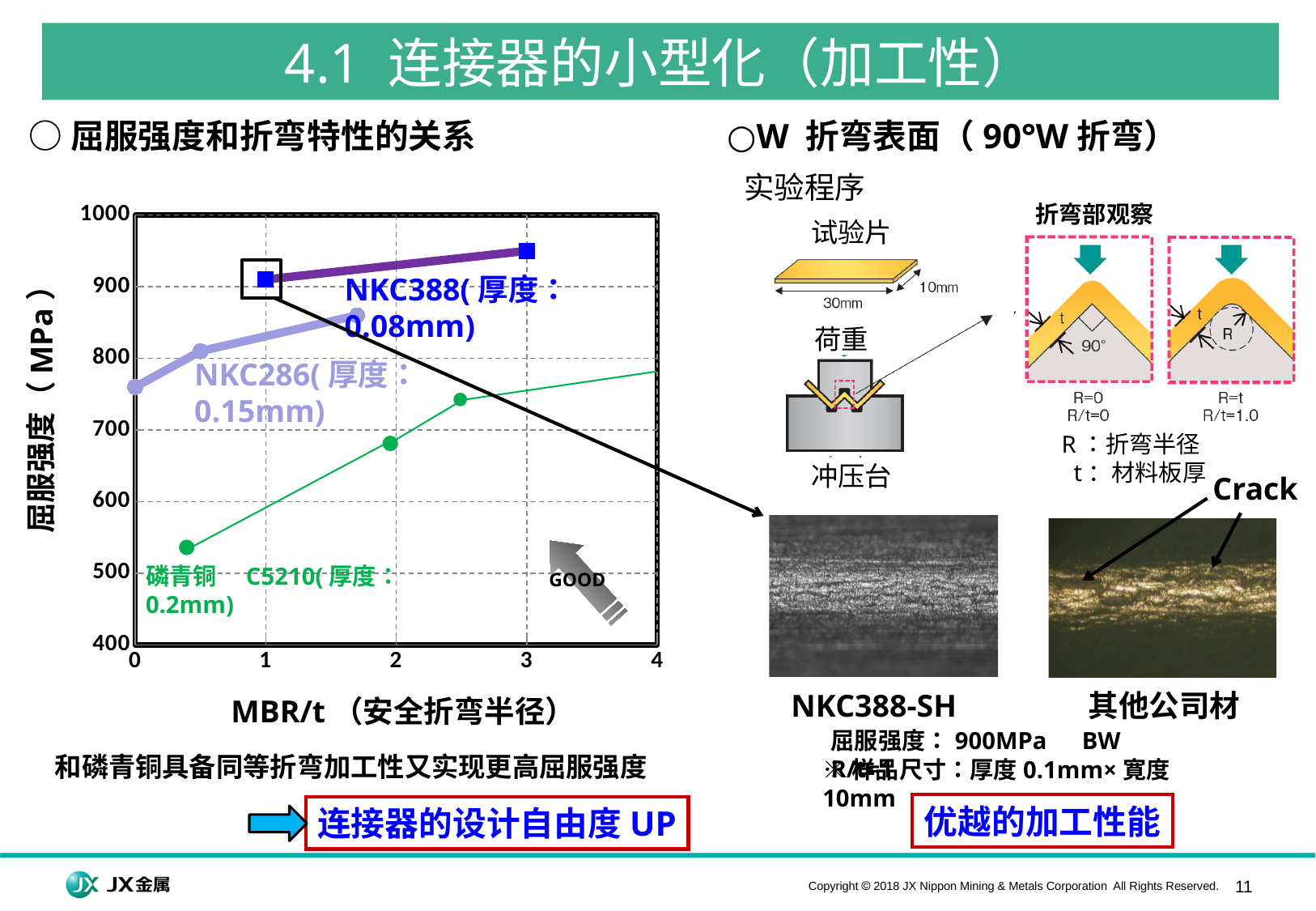
Which material series has the highest yield strength on the chart? NKC388 What is the label of the x axis of the chart? MBR/t（安全折弯半径） Is the yield strength of 磷青铜 C5210 at MBR/t = 2 greater or less than 700 MPa? less Is the yield strength of NKC286 at MBR/t = 0 greater or less than 700 MPa? greater What thickness is given for NKC388 in the chart label? 0.08mm At MBR/t = 2, which has the higher yield strength, NKC388 or 磷青铜 C5210? NKC388 What kind of chart is used to show the relationship between yield strength and bending characteristics (屈服强度和折弯特性的关系)? line chart Which material series has the lowest yield strength on the chart? 磷青铜 C5210 Is the yield strength of NKC388 at MBR/t = 1 greater or less than 800 MPa? greater How many material series are plotted on the yield strength vs MBR/t chart? 3 Does the yield strength of 磷青铜 C5210 rise or fall as MBR/t increases? rise